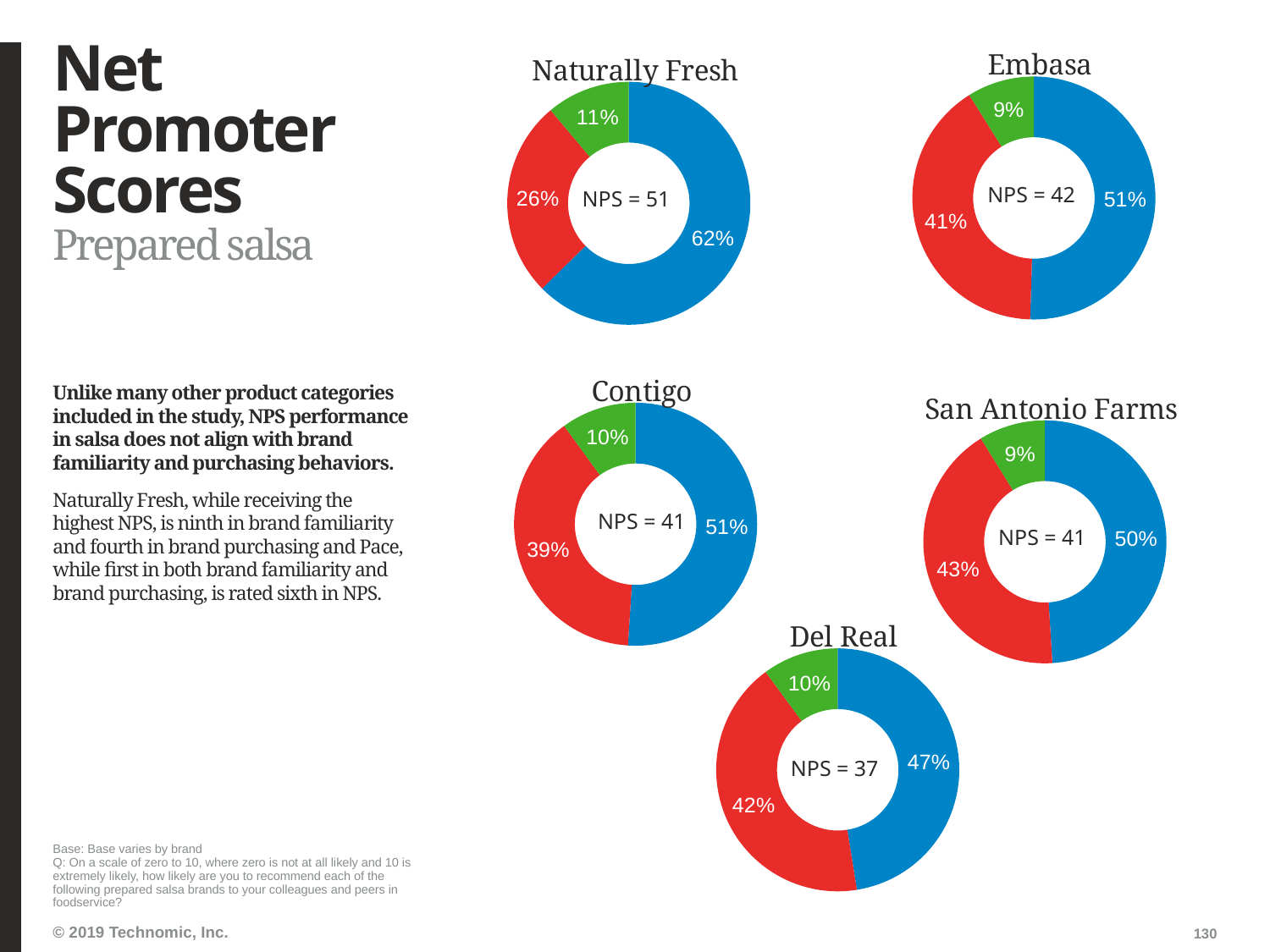
In the Del Real chart, which colour slice is the smallest? Green What kind of chart is used for each brand on the slide? Donut (pie) chart Which brand's chart shows the highest NPS value? Naturally Fresh In the Naturally Fresh chart, which colour slice is the largest? Blue In the Contigo chart, what percentage is shown for the green slice? 10% How many donut charts are shown on the slide? 5 In the Embasa chart, what percentage is shown for the red slice? 41% In the Del Real chart, what NPS value is printed in the centre? NPS = 37 In the San Antonio Farms chart, what percentage is shown for the blue slice? 50% In the Naturally Fresh chart, what percentage is shown for the blue slice? 62% Which is larger in the Embasa chart: the blue slice or the red slice? The blue slice In the Naturally Fresh chart, what is the difference between the blue slice and the red slice? 36 percentage points